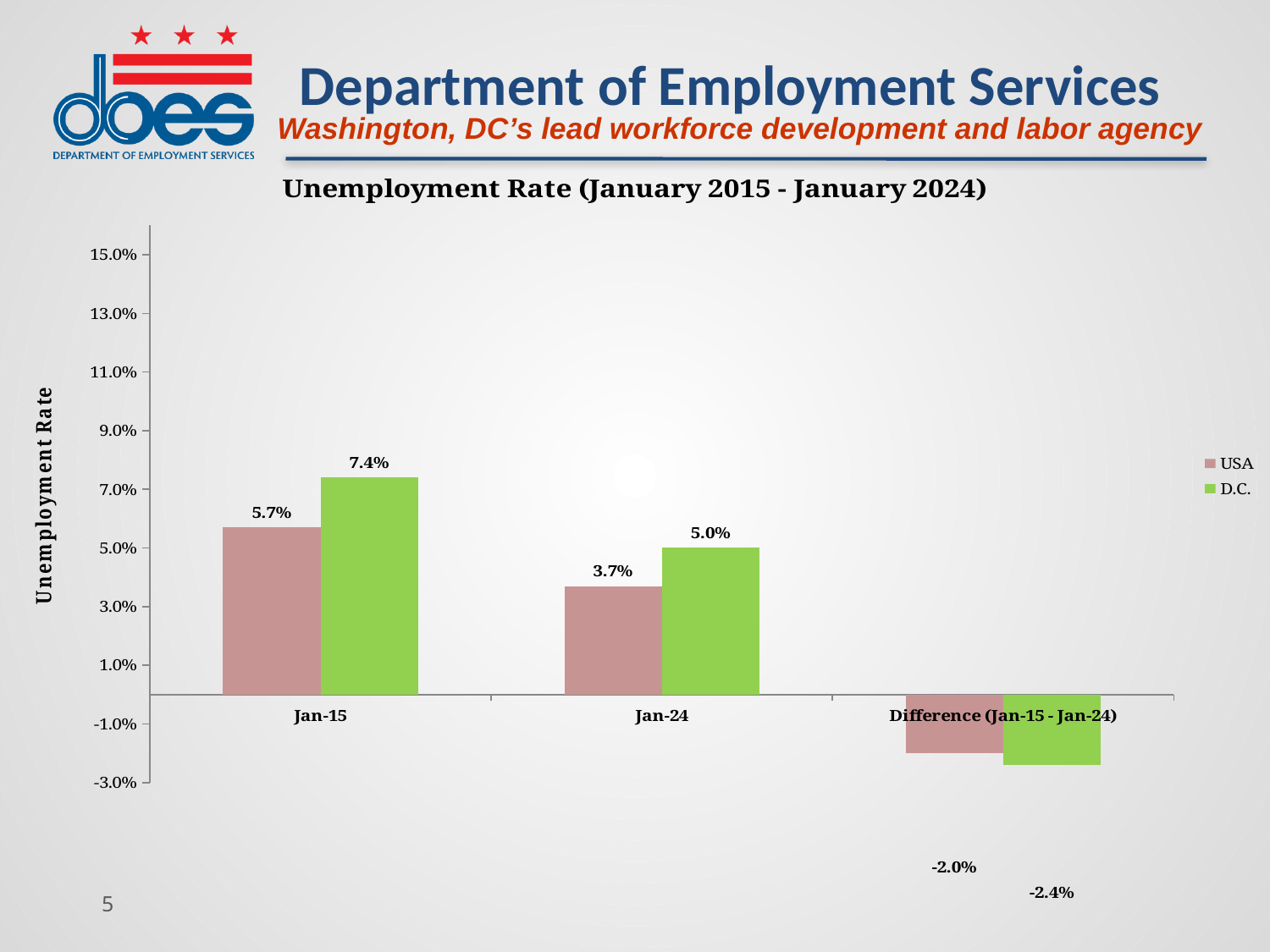
How many series does the legend list? 2 What is the difference between the D.C. and USA unemployment rates in Jan-15? 1.7% What is the USA value for Difference (Jan-15 - Jan-24)? -2.0% What is the D.C. value for Difference (Jan-15 - Jan-24)? -2.4% How many categories are shown on the x axis? 3 What is the USA unemployment rate for Jan-15? 5.7% What type of chart is shown on the slide? Bar chart Which is larger in Jan-24, the USA rate or the D.C. rate? D.C. Is the D.C. value for Jan-15 greater or less than 7.0%? greater Which category has the lowest USA value? Difference (Jan-15 - Jan-24) Which category has the highest D.C. unemployment rate? Jan-15 What is the D.C. unemployment rate for Jan-24? 5.0%